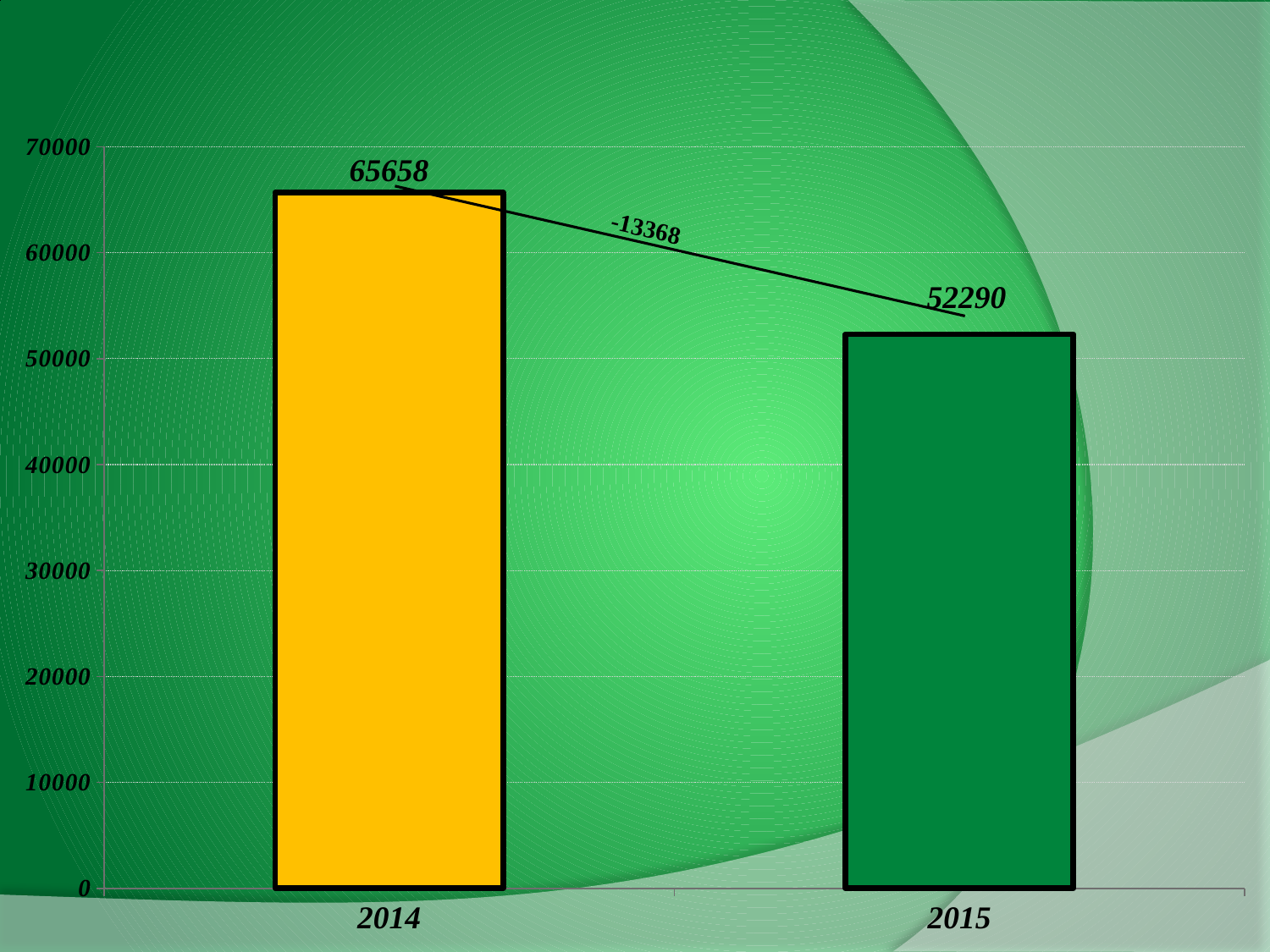
What is the difference between the 2014 value and the 2015 value? 13368 What kind of chart is shown on the slide? bar chart Is the value for 2015 greater or less than 50000? greater Which year has the higher value? 2014 What change is labelled on the line connecting the two bars? -13368 What is the value for 2015? 52290 Is the value for 2015 larger or smaller than the value for 2014? smaller Which year has the lower value? 2015 What is the value for 2014? 65658 Is the value for 2014 greater or less than 70000? less How many bars are shown in the chart? 2 Do the values rise or fall from 2014 to 2015? fall